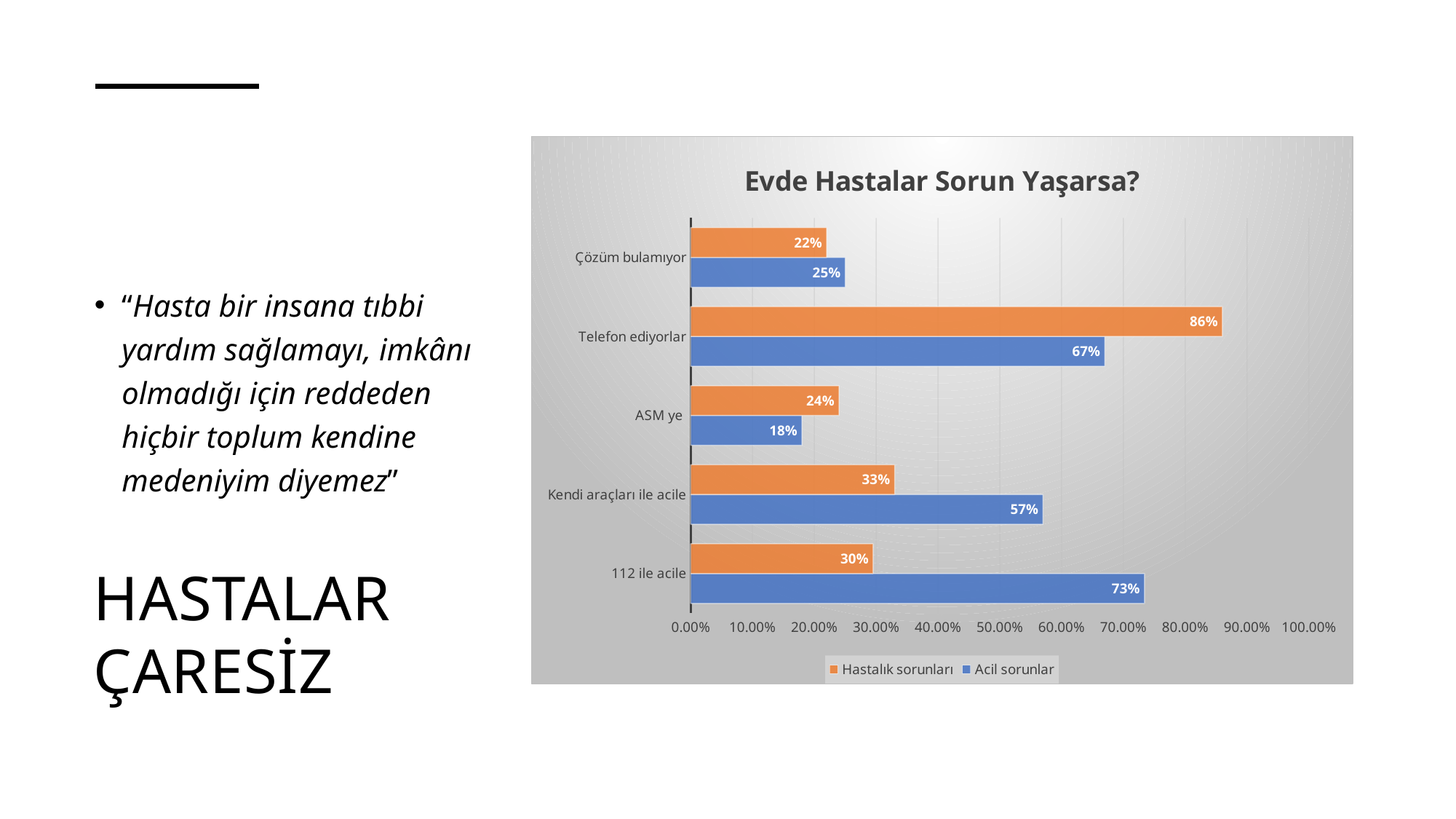
What is the value for "112 ile acile" in the "Acil sorunlar" series? 73% What is the title of the chart? Evde Hastalar Sorun Yaşarsa? What is the value for "ASM ye" in the "Acil sorunlar" series? 18% What is the value for "Telefon ediyorlar" in the "Hastalık sorunları" series? 86% Which category has the highest value in the "Acil sorunlar" series? 112 ile acile What is the difference between the "Acil sorunlar" and "Hastalık sorunları" values for "Kendi araçları ile acile"? 24% How many categories are shown on the chart? 5 For "Telefon ediyorlar", which series has the larger value: "Hastalık sorunları" or "Acil sorunlar"? Hastalık sorunları Which category has the lowest value in the "Hastalık sorunları" series? Çözüm bulamıyor What kind of chart is shown on the slide? Bar chart How many series does the legend list? 2 Is the "Acil sorunlar" value for "Kendi araçları ile acile" greater or less than 50.00%? greater